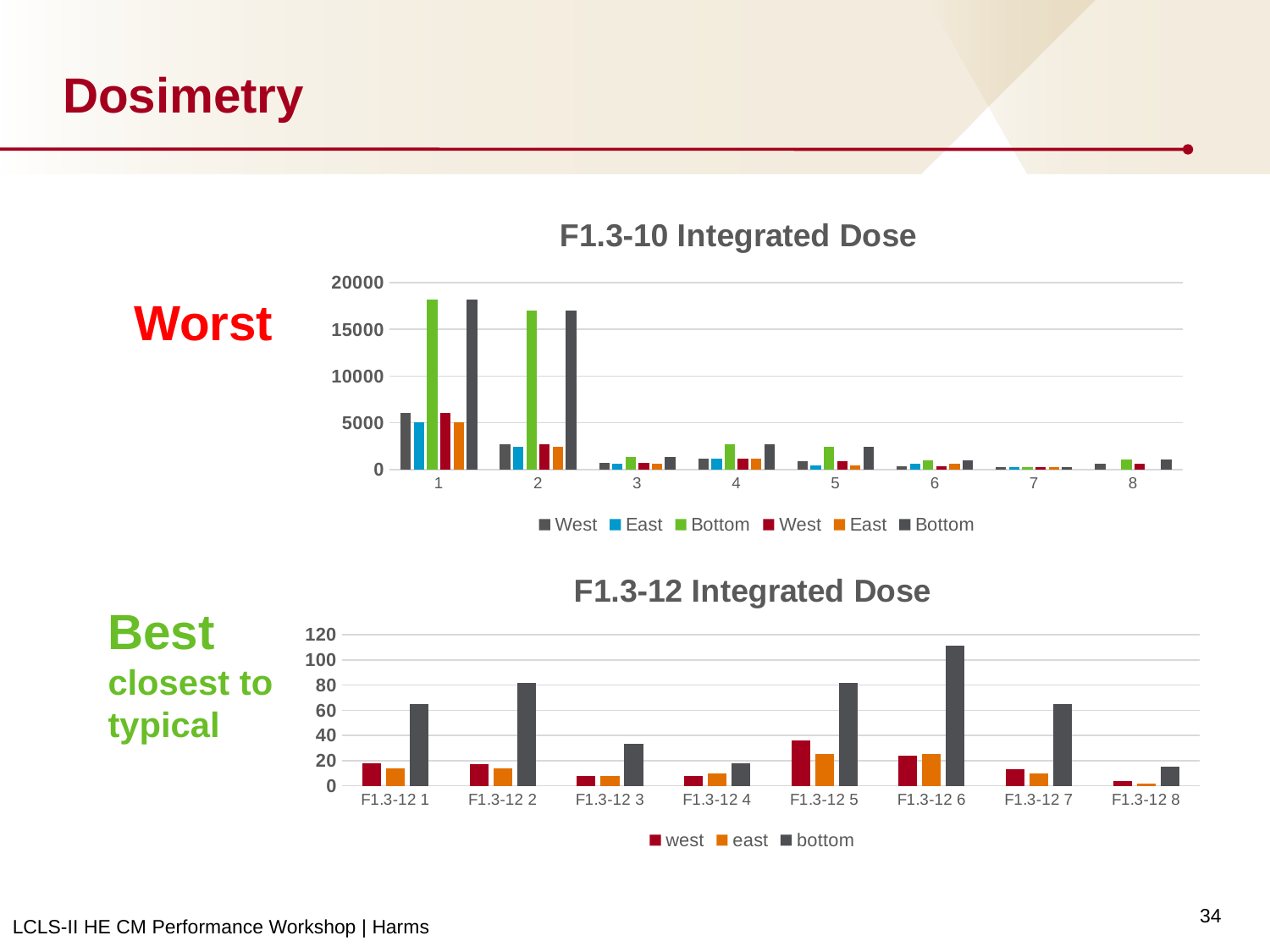
What is the title of the lower chart on the slide? F1.3-12 Integrated Dose In the 'F1.3-10 Integrated Dose' chart, is the green Bottom value for category 1 greater or less than 15000? greater In the 'F1.3-12 Integrated Dose' chart, which category has the highest west value? F1.3-12 5 What type of chart is the 'F1.3-10 Integrated Dose' chart? bar chart In the 'F1.3-12 Integrated Dose' chart, which is larger: the bottom value for F1.3-12 2 or for F1.3-12 3? F1.3-12 2 In the 'F1.3-12 Integrated Dose' chart, is the bottom value for F1.3-12 6 greater or less than 100? greater How many categories are shown on the x axis of the 'F1.3-12 Integrated Dose' chart? 8 How many series does the legend of the 'F1.3-12 Integrated Dose' chart list? 3 How many series does the legend of the 'F1.3-10 Integrated Dose' chart list? 6 In the 'F1.3-10 Integrated Dose' chart, is the green Bottom value for category 3 greater or less than 5000? less In the 'F1.3-12 Integrated Dose' chart, which category has the highest bottom value? F1.3-12 6